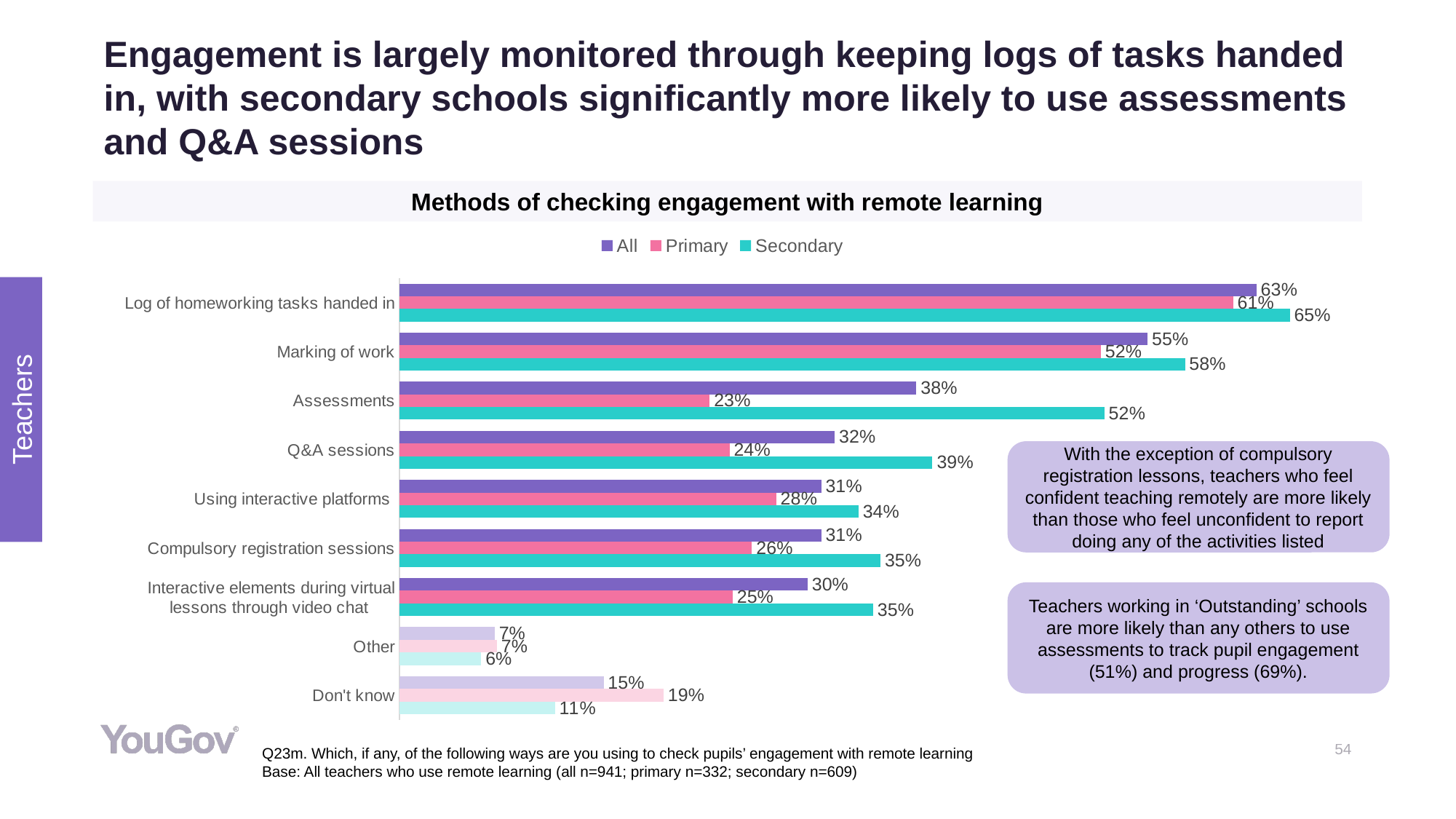
What kind of chart is shown on the slide? Bar chart What is the title of the chart? Methods of checking engagement with remote learning How many series does the legend list? 3 What is the Primary value for 'Don't know'? 19% What is the difference between the Secondary and Primary values for Assessments? 29 percentage points Which method has the highest value for the 'All' series? Log of homeworking tasks handed in Which category has the lowest value for the Secondary series? Other What percentage of Secondary teachers report using assessments to check engagement? 52% How many categories are shown on the chart? 9 What is the 'All' value for Q&A sessions? 32% For Q&A sessions, which is larger: the Primary value or the Secondary value? Secondary What is the value for Primary teachers for 'Log of homeworking tasks handed in'? 61%